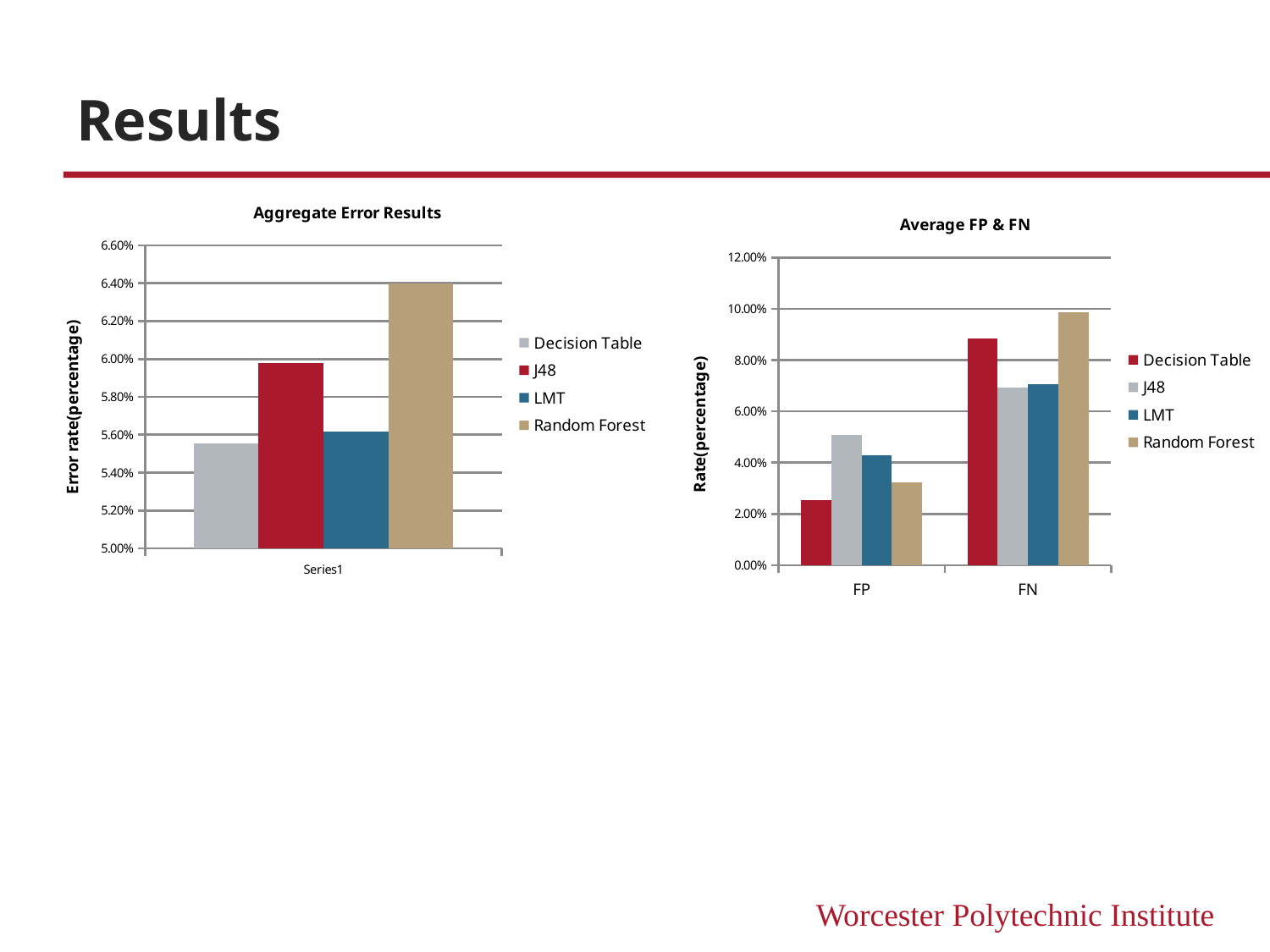
How many categories are shown on the x axis of the 'Average FP & FN' chart? 2 In the 'Aggregate Error Results' chart, which series has the lowest error rate? Decision Table In the 'Average FP & FN' chart, which series has the highest FN value? Random Forest In the 'Aggregate Error Results' chart, is the value for J48 greater or less than 5.80%? greater In the 'Aggregate Error Results' chart, which series has the highest error rate? Random Forest In the 'Aggregate Error Results' chart, which is larger, the value for J48 or the value for LMT? J48 In the 'Average FP & FN' chart, which series has the lowest FP value? Decision Table In the 'Average FP & FN' chart, is the FN value for Decision Table greater or less than 8.00%? greater How many series does the legend of the 'Aggregate Error Results' chart list? 4 What is the y-axis label of the 'Average FP & FN' chart? Rate(percentage) What kind of chart is the 'Aggregate Error Results' chart? bar chart In the 'Average FP & FN' chart, do the values for Random Forest rise or fall from FP to FN? rise